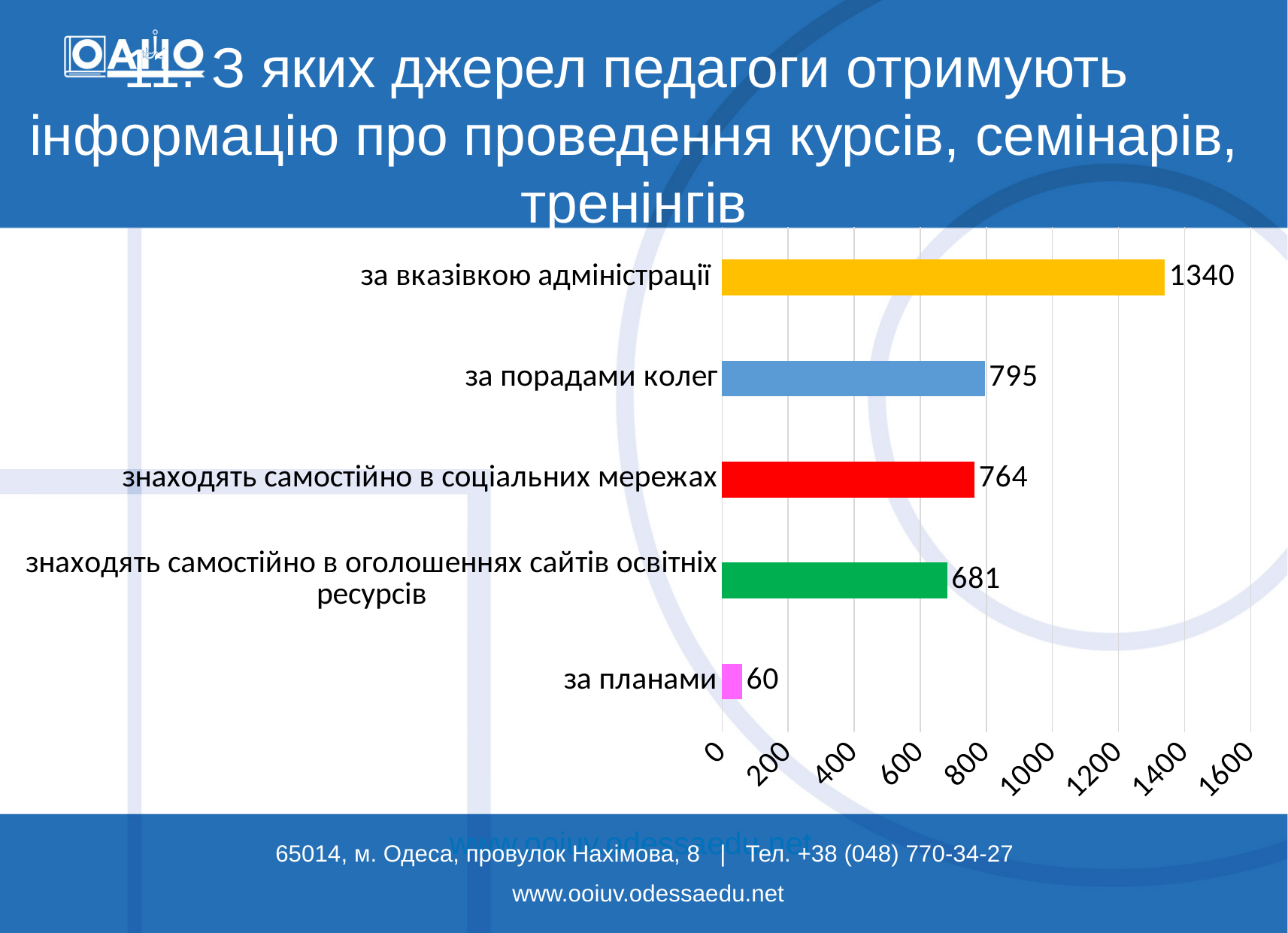
What is the value for "за планами"? 60 What is the value for "за порадами колег"? 795 What kind of chart is shown on the slide? bar chart Which is larger: the value for "знаходять самостійно в соціальних мережах" or the value for "знаходять самостійно в оголошеннях сайтів освітніх ресурсів"? знаходять самостійно в соціальних мережах What is the value for "за вказівкою адміністрації"? 1340 Which category has the lowest value? за планами How many categories are shown in the chart? 5 What is the difference between the values for "за вказівкою адміністрації" and "за порадами колег"? 545 Is the value for "знаходять самостійно в оголошеннях сайтів освітніх ресурсів" greater or less than 800? less Which category has the highest value? за вказівкою адміністрації What is the value for "знаходять самостійно в соціальних мережах"? 764 What is the difference between the values for "за порадами колег" and "знаходять самостійно в соціальних мережах"? 31